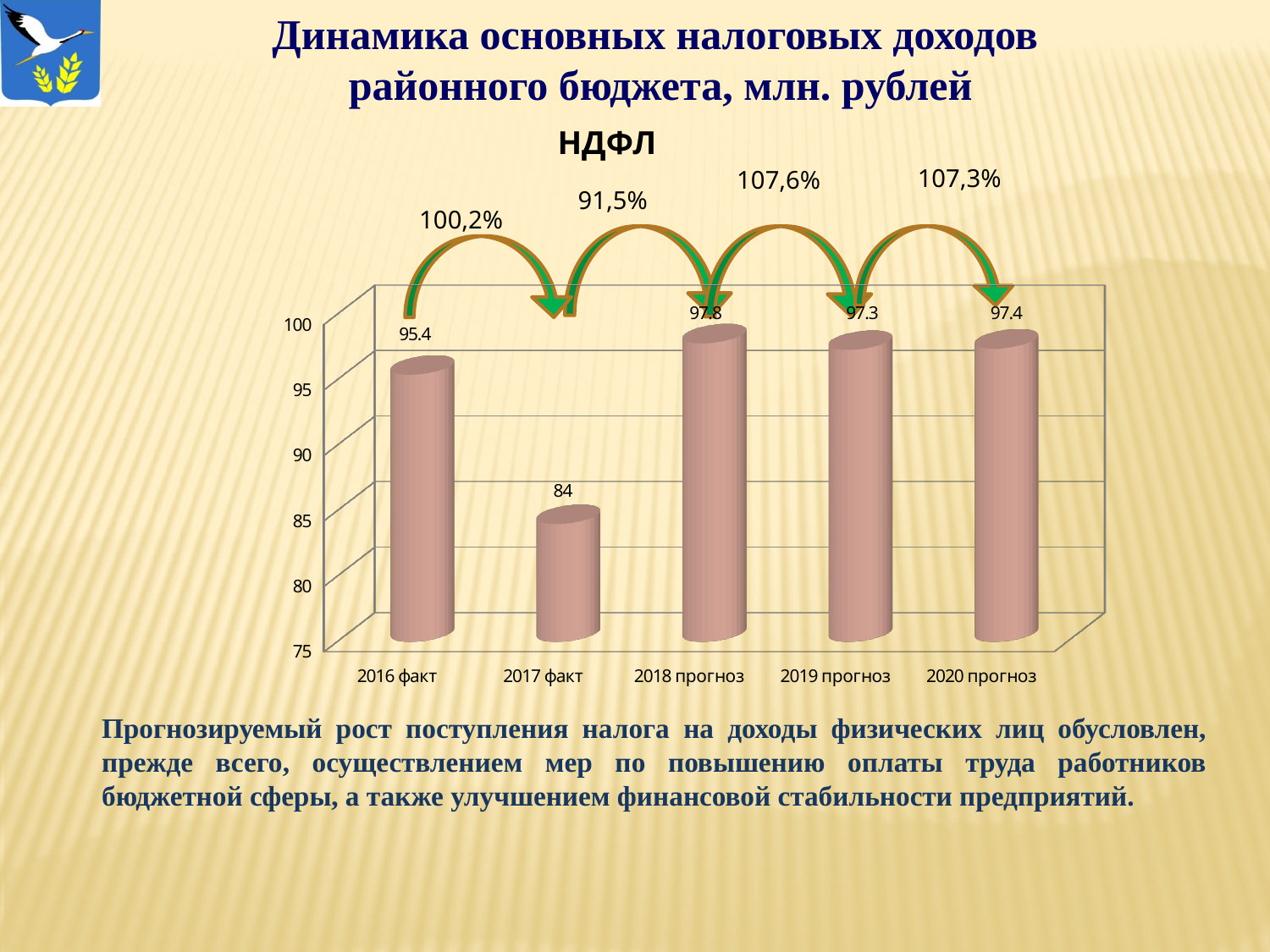
What is the value for 2020 прогноз in the НДФЛ chart? 97.4 What is the value for 2016 факт in the НДФЛ chart? 95.4 Which is larger in the НДФЛ chart: the value for 2016 факт or the value for 2019 прогноз? 2019 прогноз Which category has the highest value in the НДФЛ chart? 2018 прогноз What percentage is shown above the arrow between 2017 факт and 2018 прогноз in the НДФЛ chart? 91,5% How many categories are shown on the x axis of the НДФЛ chart? 5 Which category has the lowest value in the НДФЛ chart? 2017 факт What kind of chart is the НДФЛ chart? bar chart Is the value for 2017 факт in the НДФЛ chart greater or less than 85? less What is the value for 2018 прогноз in the НДФЛ chart? 97.8 What is the difference between the values for 2018 прогноз and 2017 факт in the НДФЛ chart? 13.8 What is the value for 2017 факт in the НДФЛ chart? 84